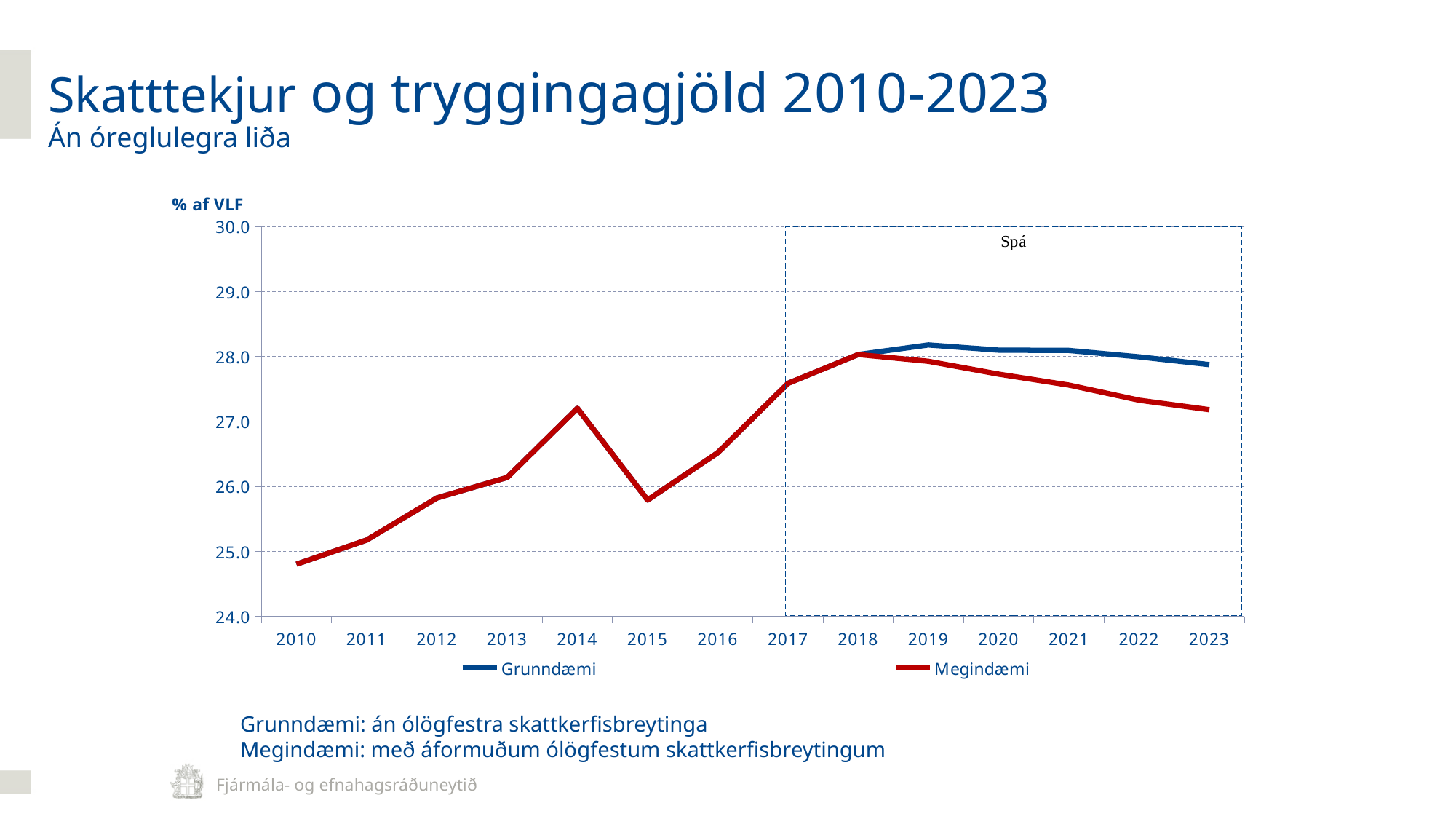
For Megindæmi, which year has the higher value, 2014 or 2015? 2014 Do the Megindæmi values rise or fall from 2019 to 2023? fall Which year has the lowest value for Megindæmi? 2010 Is the value for Megindæmi in 2015 greater or less than 26.0? less How many years are shown on the x axis? 14 What label is shown on the y axis of the chart? % af VLF Is the value for Megindæmi in 2017 greater or less than 27.0? greater What kind of chart is shown on the slide? line chart Is the value for Megindæmi in 2010 greater or less than 25.0? less In 2023, which series has the higher value, Grunndæmi or Megindæmi? Grunndæmi How many series does the legend list? 2